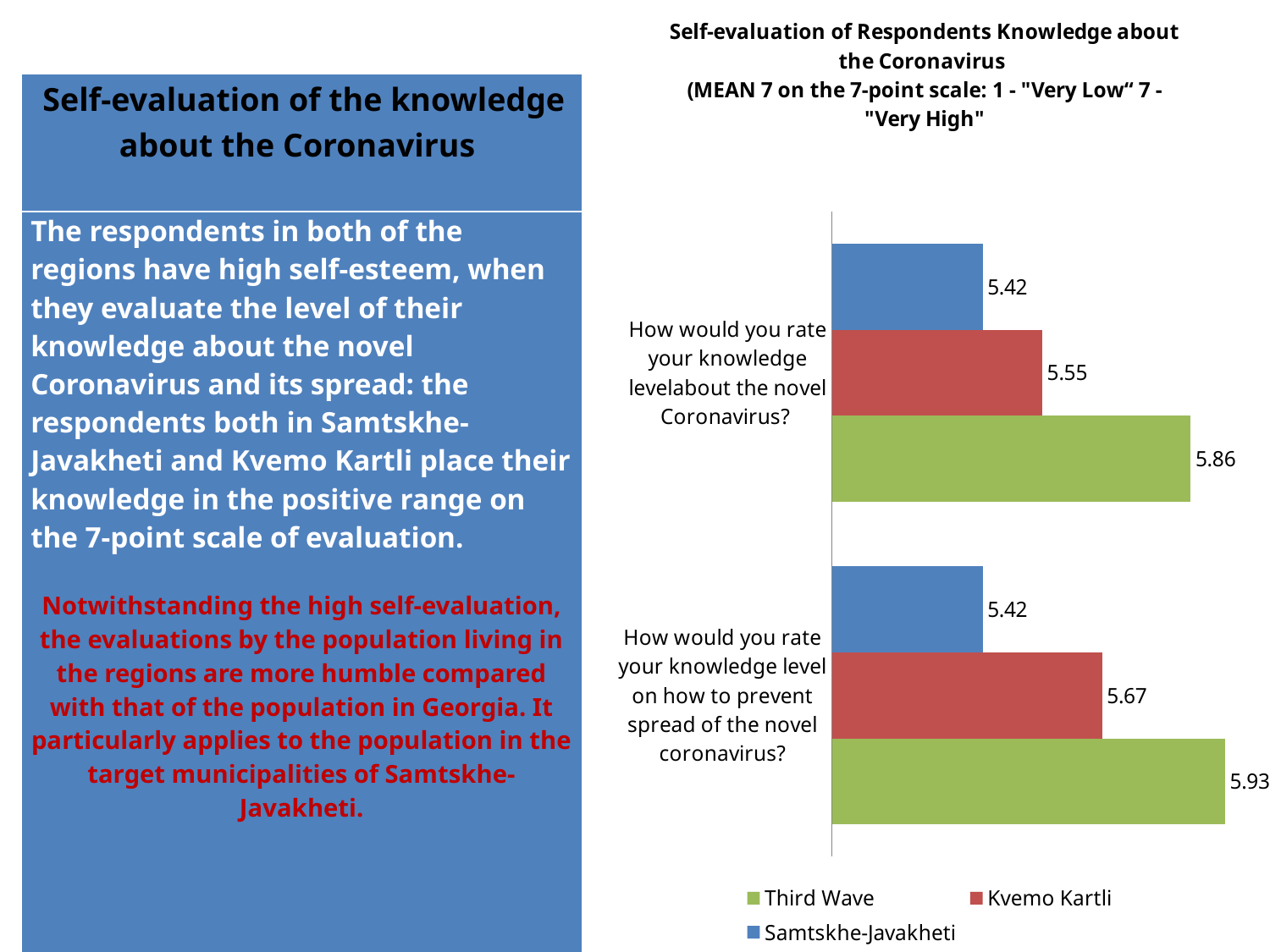
What is the difference between the Third Wave and Samtskhe-Javakheti values for "How would you rate your knowledge level on how to prevent spread of the novel coronavirus?"? 0.51 Which series has the highest value for "How would you rate your knowledge level on how to prevent spread of the novel coronavirus?"? Third Wave Which series has the lowest value for "How would you rate your knowledge level about the novel Coronavirus?"? Samtskhe-Javakheti Which series is shown in green on the chart? Third Wave What is the difference between the Kvemo Kartli and Samtskhe-Javakheti values for "How would you rate your knowledge level about the novel Coronavirus?"? 0.13 What is the Third Wave value for "How would you rate your knowledge level about the novel Coronavirus?"? 5.86 What is the Kvemo Kartli value for "How would you rate your knowledge level on how to prevent spread of the novel coronavirus?"? 5.67 What is the Samtskhe-Javakheti value for "How would you rate your knowledge level about the novel Coronavirus?"? 5.42 Which is larger: the Kvemo Kartli value for the question about knowledge level about the novel Coronavirus, or the Kvemo Kartli value for the question about preventing spread? the question about preventing spread (5.67) How many question categories are plotted on the chart? 2 How many series does the chart legend list? 3 What kind of chart is shown on the slide? bar chart